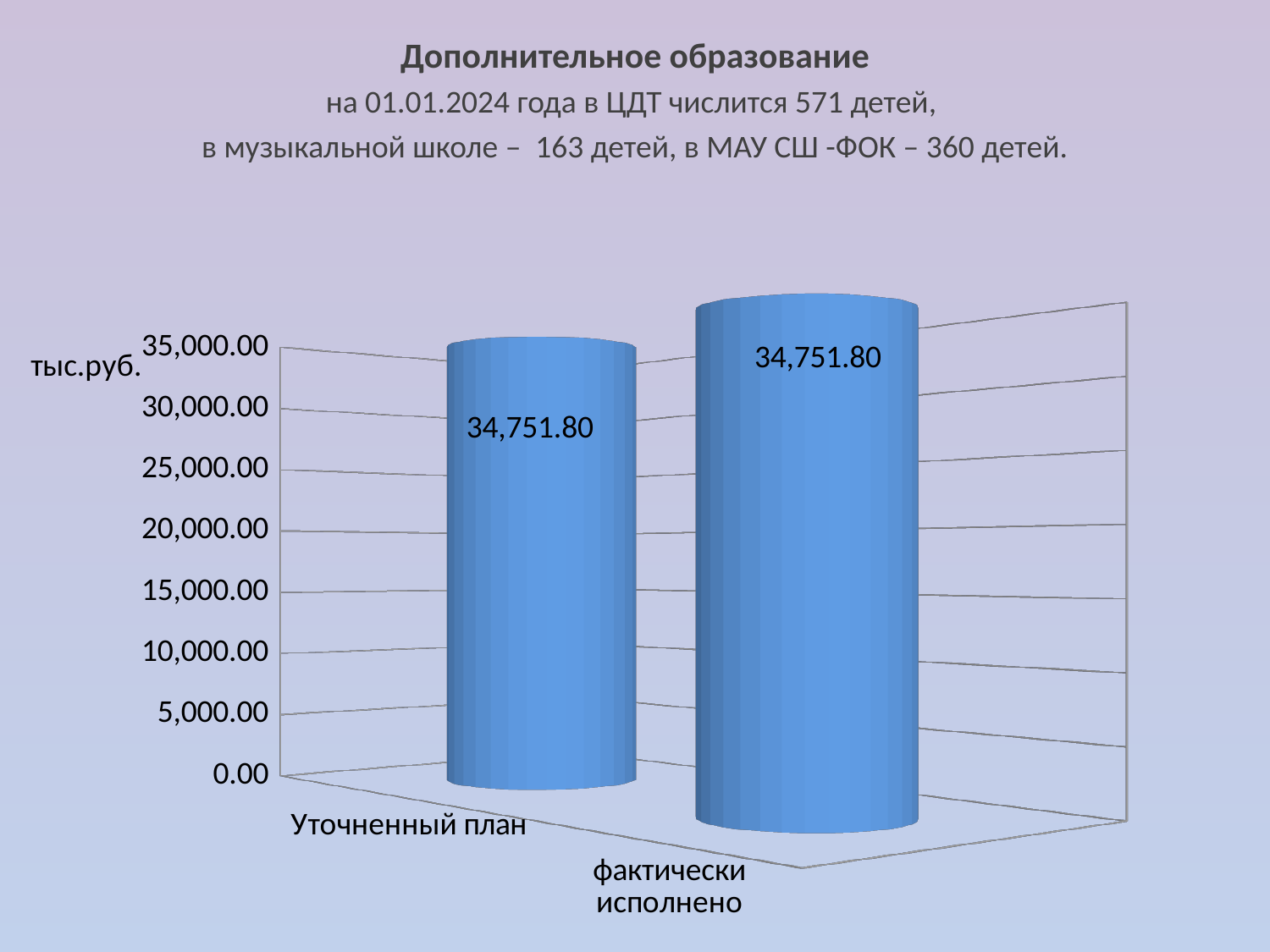
What is the value for Уточненный план? 34,751.80 What is the difference between the values for Уточненный план and фактически исполнено? 0.00 What kind of chart is shown on the slide? bar chart Is the value for фактически исполнено greater or less than 35,000.00? less What is the highest value shown on the vertical axis of the chart? 35,000.00 What is the value for фактически исполнено? 34,751.80 Is the value for фактически исполнено larger than, smaller than, or equal to the value for Уточненный план? equal What unit label is shown next to the vertical axis of the chart? тыс.руб. How many categories are shown on the chart? 2 What is the title of the slide containing the chart? Дополнительное образование Is the value for Уточненный план greater or less than 30,000.00? greater